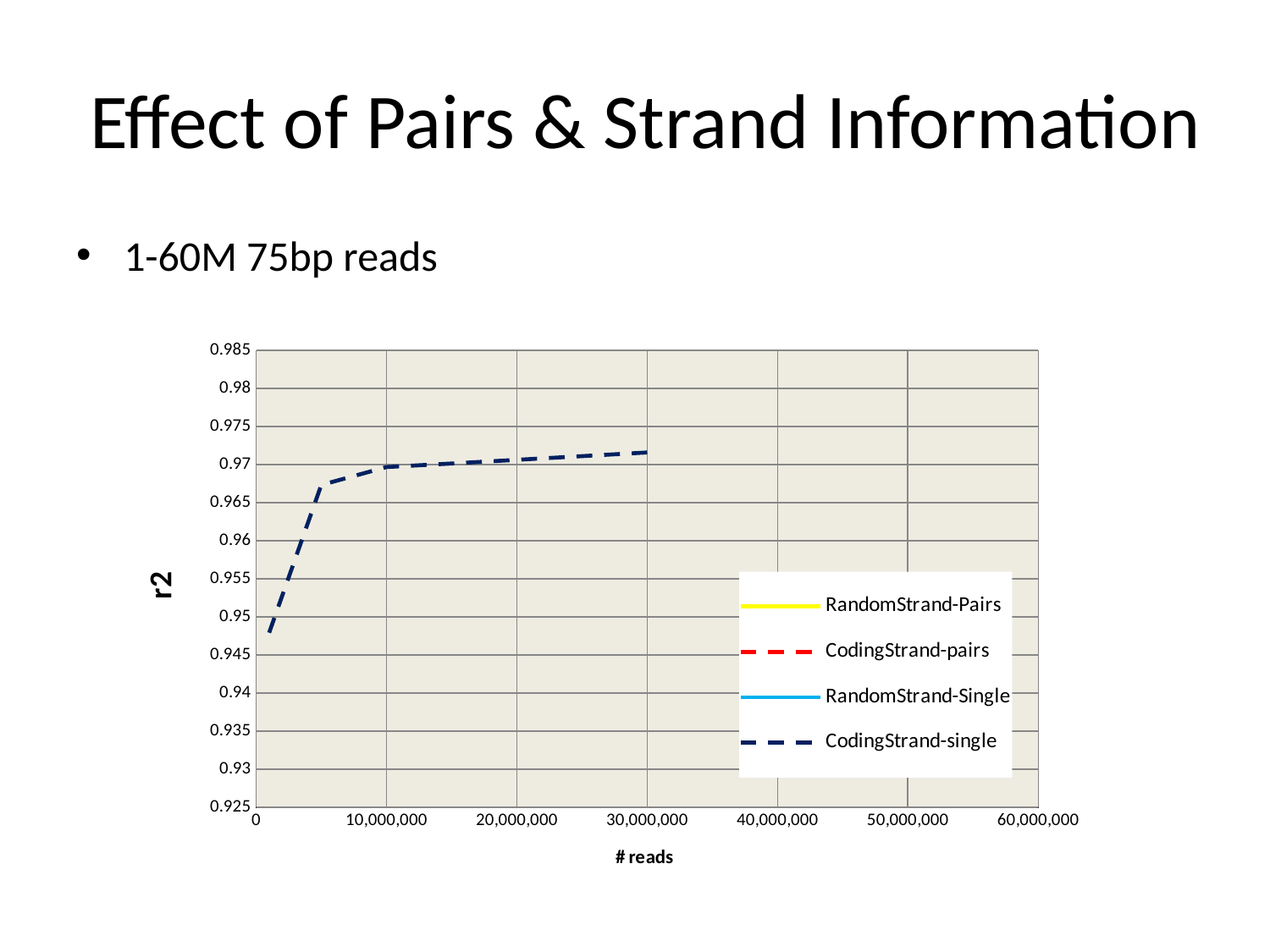
What kind of chart is shown on the slide? line chart Does the plotted CodingStrand-single line rise or fall as the number of reads increases? rises Is the r2 value of the CodingStrand-single line at 10,000,000 reads greater or less than 0.965? greater Is the r2 value of the CodingStrand-single line at 20,000,000 reads greater or less than 0.96? greater What is the label of the x axis? # reads Is the r2 value of the CodingStrand-single line at its leftmost point (near 0 reads) greater or less than 0.955? less How many series does the chart legend list? 4 What is the label of the y axis? r2 What is the highest value shown on the x axis? 60,000,000